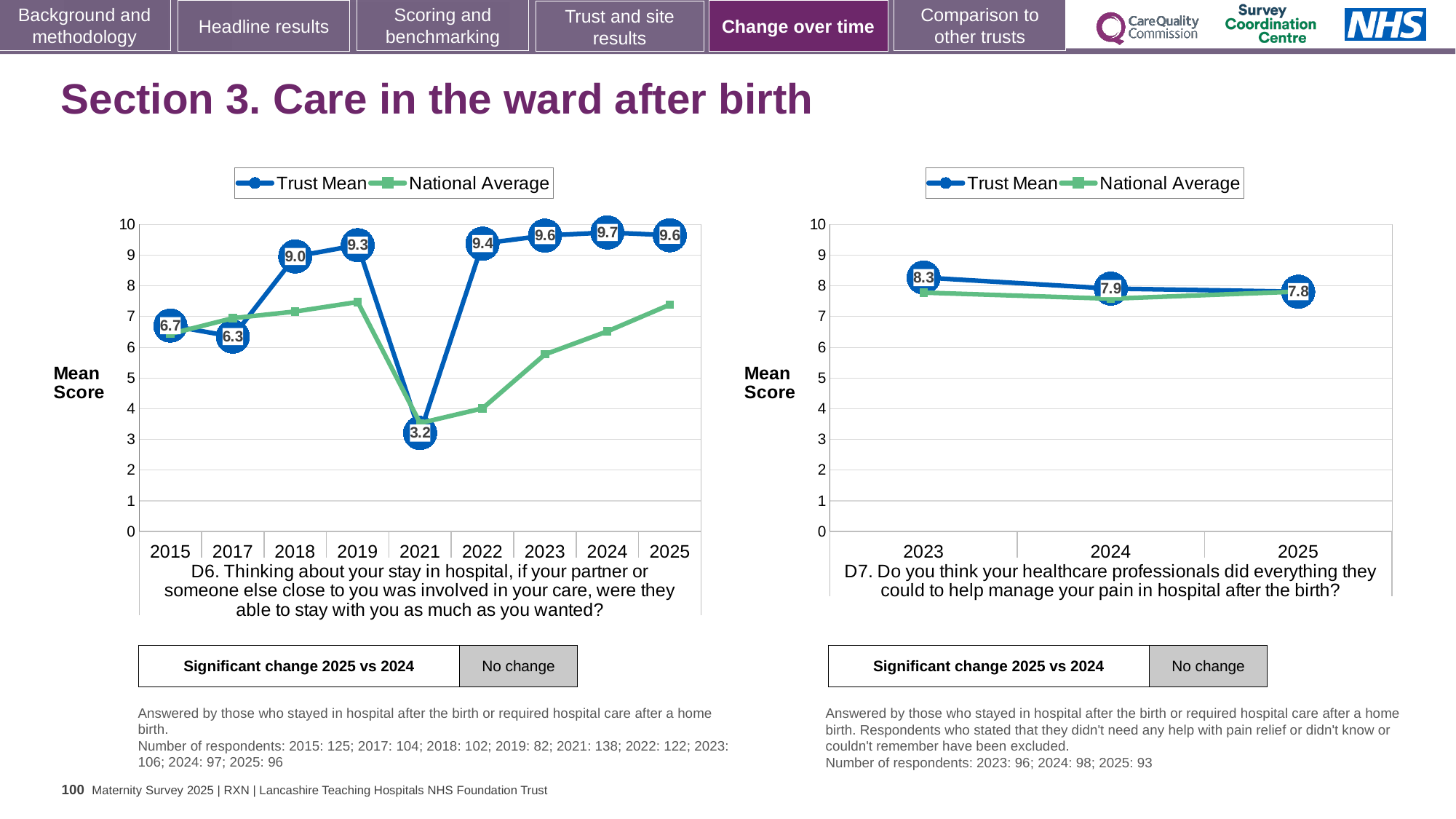
In the left chart (D6), what is the Trust Mean for 2021? 3.2 In the left chart (D6), is the National Average for 2025 greater or less than 7? greater In the left chart (D6), what is the difference between the Trust Mean for 2022 and the Trust Mean for 2021? 6.2 What kind of chart is the left chart (D6)? line chart In the left chart (D6), which year has the lowest Trust Mean? 2021 In the left chart (D6), what is the Trust Mean for 2024? 9.7 In the right chart (D7), which is larger, the Trust Mean for 2023 or the Trust Mean for 2025? 2023 In the left chart (D6), how many years are shown on the x axis? 9 In the right chart (D7), what is the Trust Mean for 2023? 8.3 In the right chart (D7), does the Trust Mean rise or fall from 2023 to 2025? fall How many series does the legend of the right chart (D7) list? 2 In the left chart (D6), which year has the highest Trust Mean? 2024